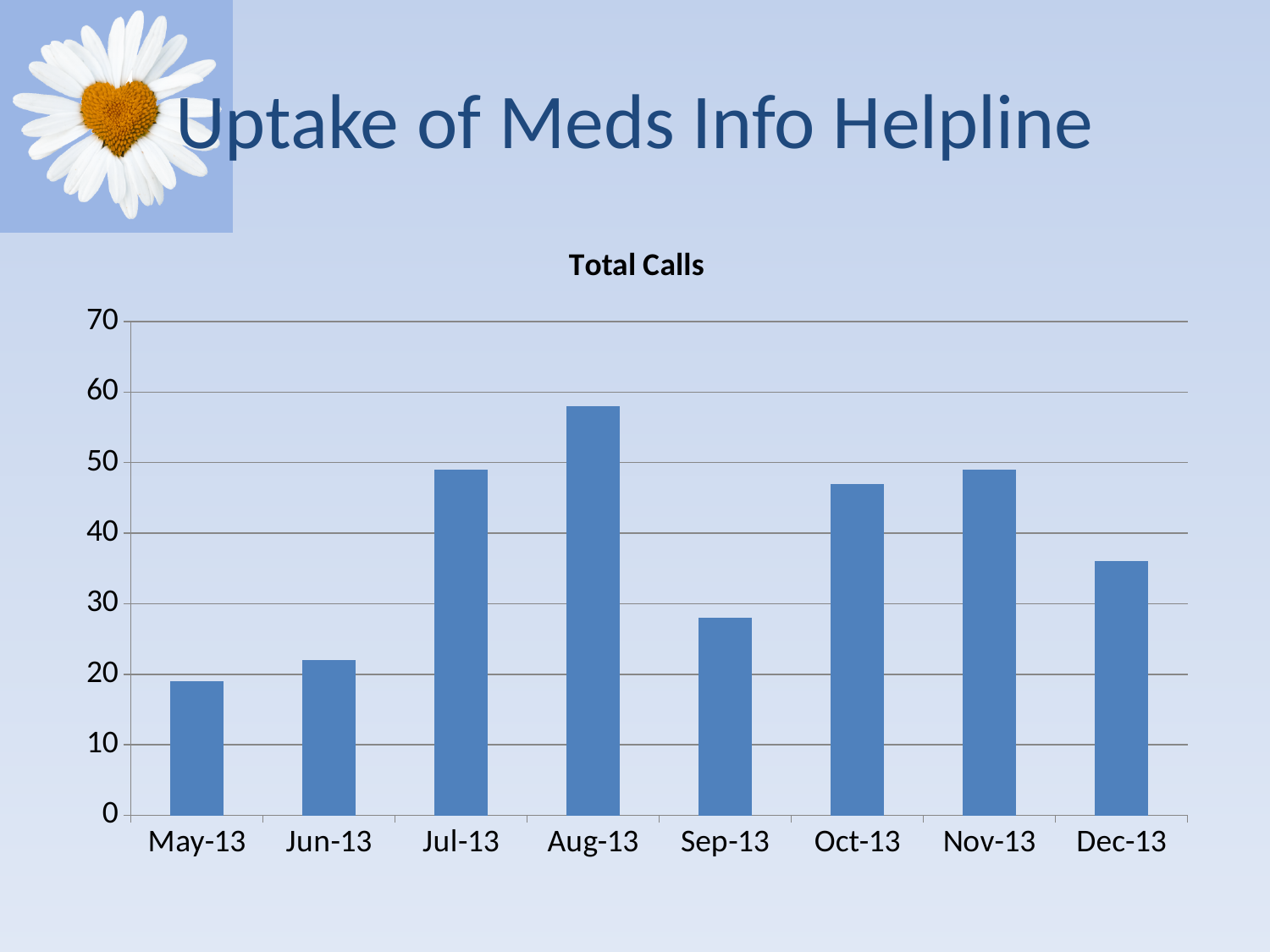
How many months are shown on the x axis of the chart? 8 Which month has the lowest number of total calls? May-13 What kind of chart is shown on the slide? bar chart Is the value for Oct-13 greater or less than 40? greater Which month has more total calls, Sep-13 or Dec-13? Dec-13 Is the value for Aug-13 greater or less than 50? greater Is the value for Dec-13 greater or less than 40? less Which month has more total calls, Aug-13 or Oct-13? Aug-13 What is the title of the chart? Total Calls Which month has the highest number of total calls? Aug-13